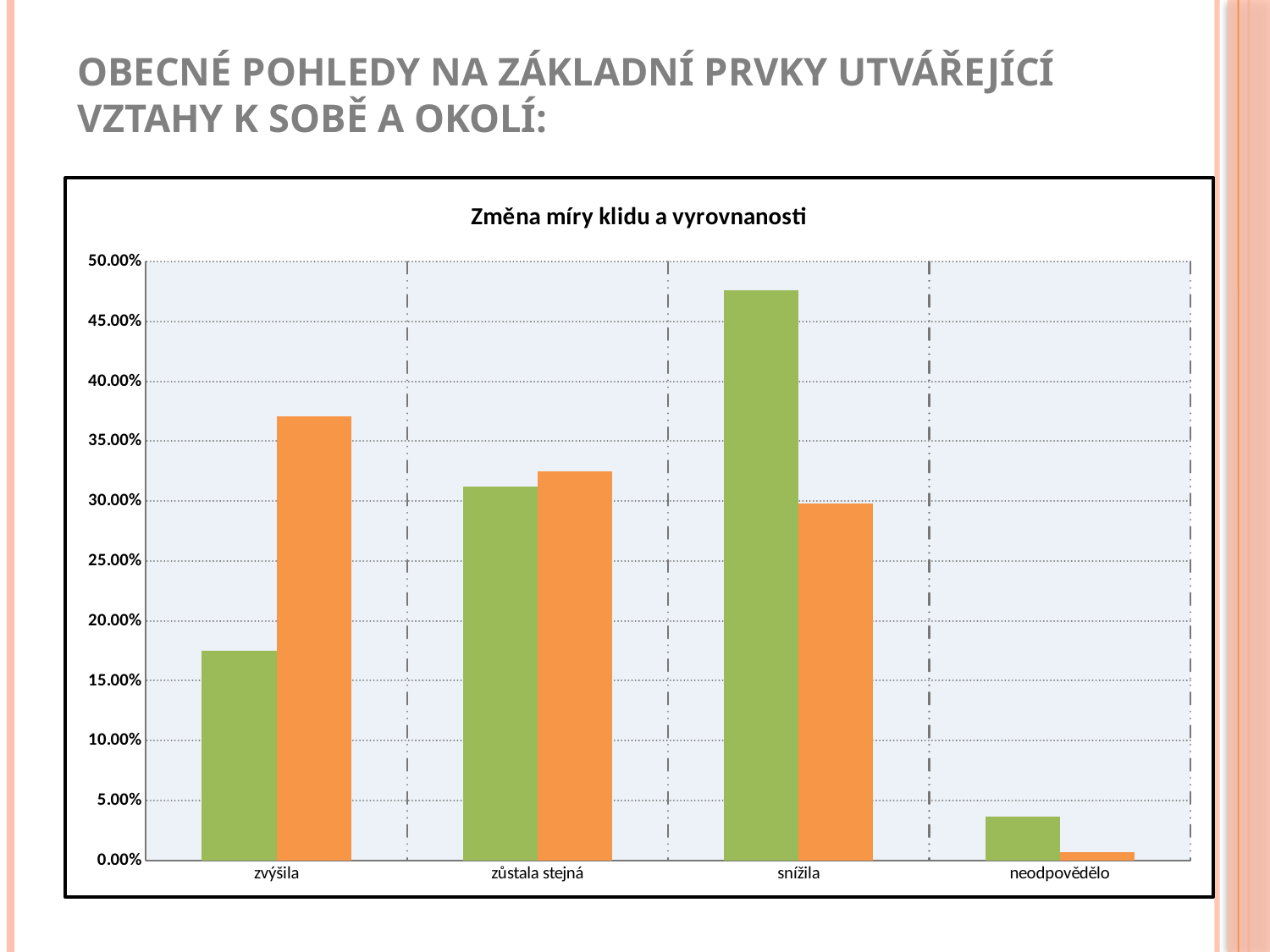
Which category has the tallest green bar? snížila Is the green bar for snížila greater or less than 45.00%? greater Which category has the tallest orange bar? zvýšila Is the green bar for zvýšila greater or less than 20.00%? less How many bars are plotted for each category in the chart? 2 What is the title of the chart? Změna míry klidu a vyrovnanosti What kind of chart is shown on the slide? bar chart Which category has the shortest orange bar? neodpovědělo How many categories are shown on the x axis of the chart? 4 Is the orange bar for zvýšila greater or less than 35.00%? greater For the category snížila, which bar is taller, the green one or the orange one? green For the category zvýšila, which bar is taller, the green one or the orange one? orange